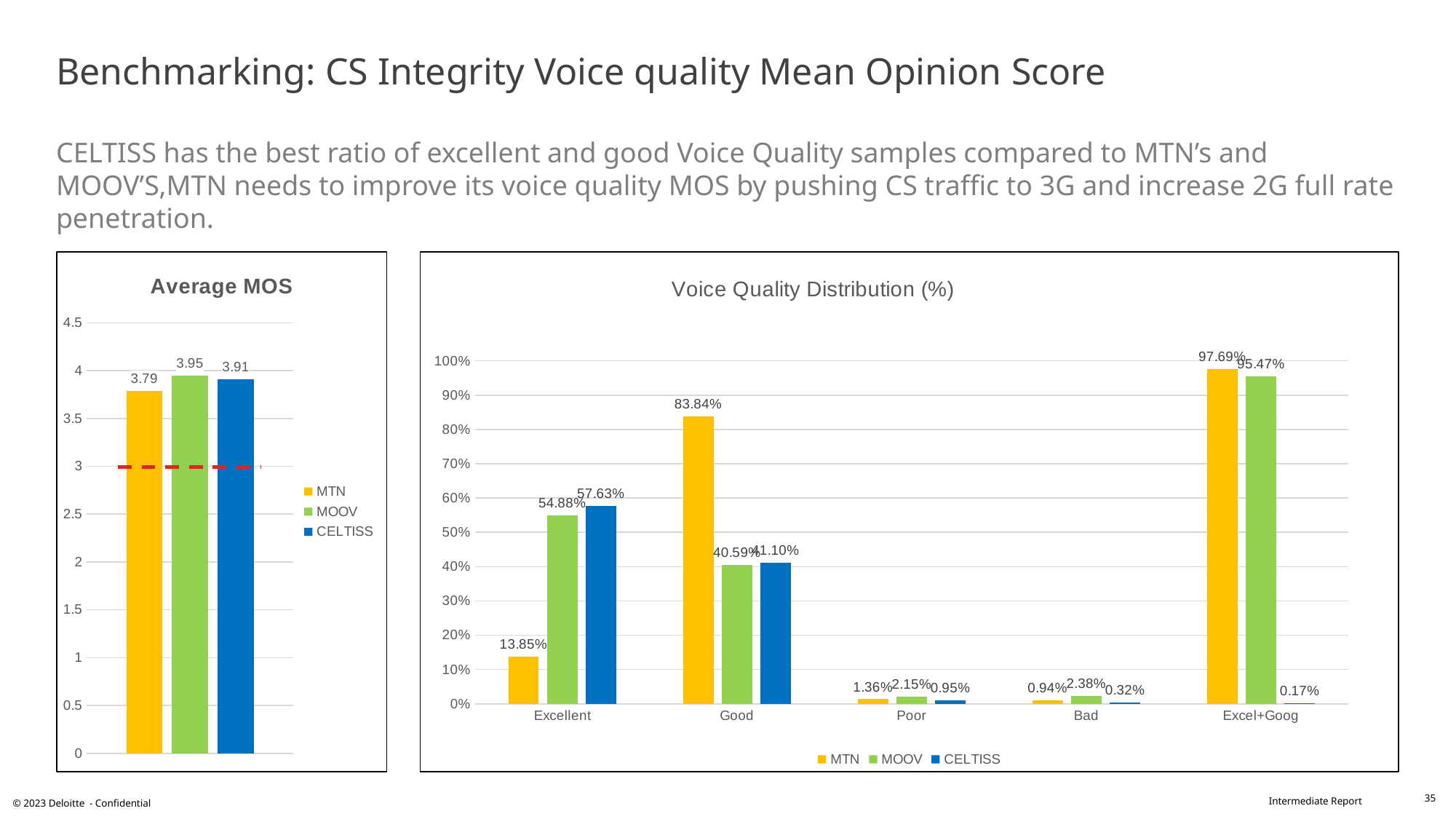
In the Voice Quality Distribution (%) chart, what is the value for CELTISS in the Excellent category? 57.63% In the Average MOS chart, which operator has the highest average MOS? MOOV In the Average MOS chart, what colour are the CELTISS bars? Blue In the Average MOS chart, what is the value for MTN? 3.79 In the Voice Quality Distribution (%) chart, which operator has the lowest value in the Excellent category? MTN In the Voice Quality Distribution (%) chart, how many categories are shown on the x axis? 5 In the Average MOS chart, how many series does the legend list? 3 In the Voice Quality Distribution (%) chart, which is larger in the Bad category, MOOV or CELTISS? MOOV In the Average MOS chart, what is the difference between MOOV's and MTN's values? 0.16 In the Voice Quality Distribution (%) chart, what is the value for MTN in the Good category? 83.84% What kind of chart is the Voice Quality Distribution (%) chart? Bar chart In the Voice Quality Distribution (%) chart, what is the difference between MTN's and MOOV's values in the Excel+Goog category? 2.22%